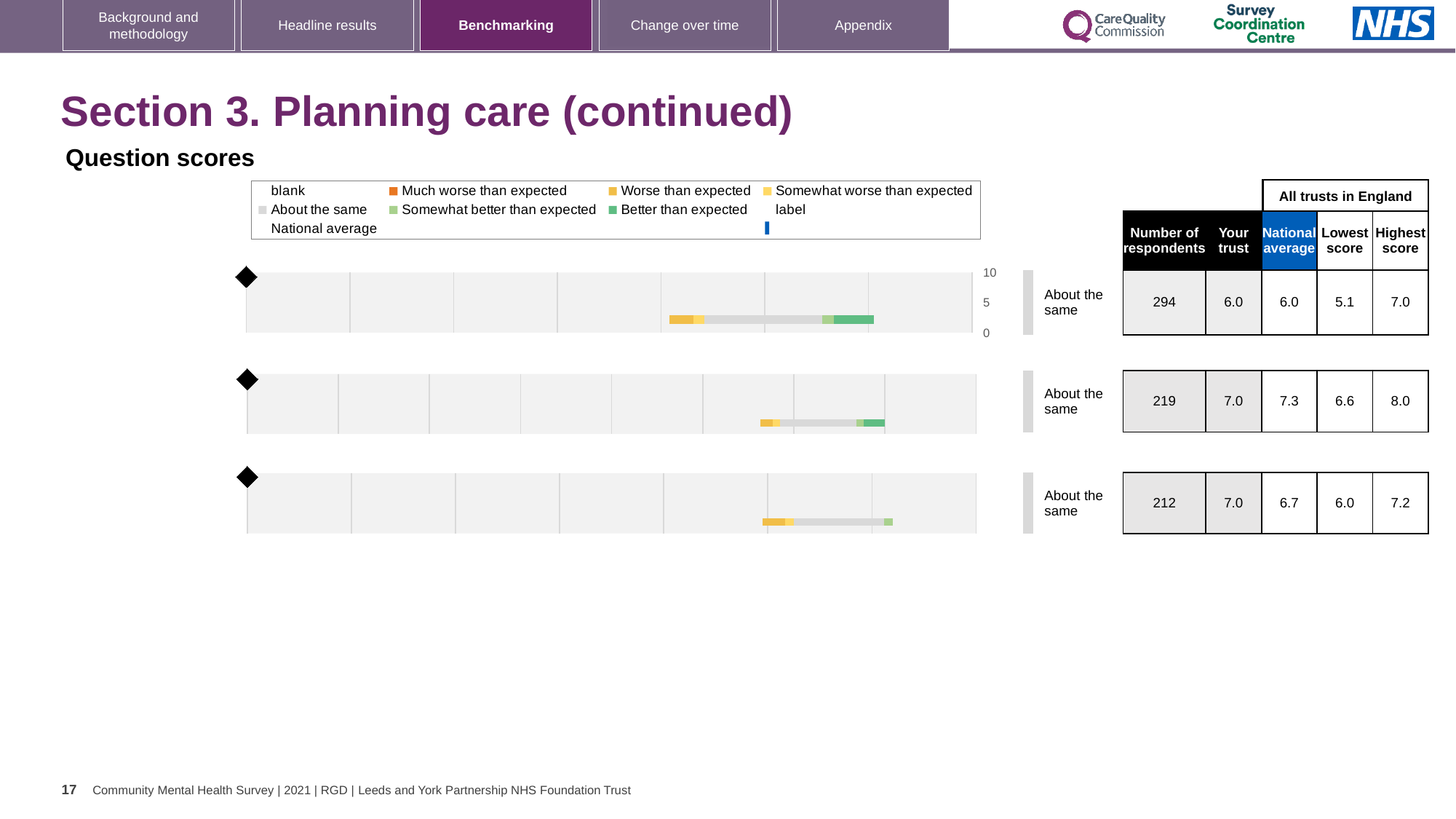
What kind of chart is used for the three question score rows on the slide? bar chart For the middle chart, what is the difference between the highest score (8.0) and the lowest score (6.6)? 1.4 For the top chart, what is the difference between the highest score (7.0) and the lowest score (5.1)? 1.9 For the top chart, how many respondents are listed in the table? 294 Which of the three charts has the largest number of respondents? The top chart (294) For the middle chart, what is the national average score shown in the table? 7.3 For the bottom chart, what is the highest score among all trusts in England? 7.2 For the top chart, what is the 'Your trust' score shown in the table? 6.0 What is the maximum value shown on the vertical axis of the top chart? 10 For the middle chart, which is larger: the 'Your trust' score or the national average? National average How many question score charts are shown on the slide? 3 What benchmark category label is shown next to the bottom chart? About the same